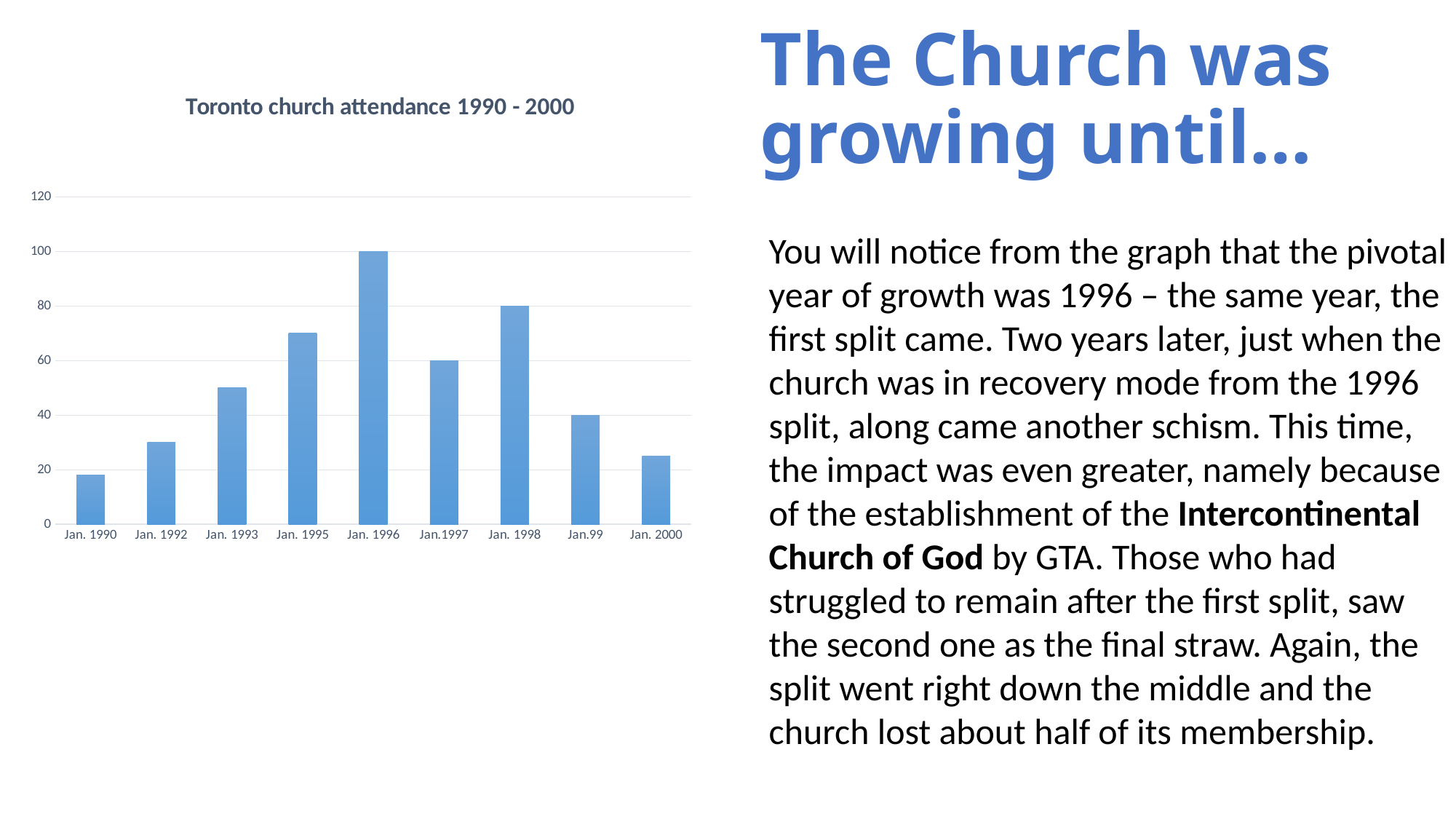
What is the attendance value for Jan. 1996? 100 How many bars (time points) are shown in the chart? 9 What is the attendance value for Jan.99? 40 What is the difference in attendance between Jan. 1996 and Jan. 1998? 20 Which time point has the highest attendance? Jan. 1996 Is the attendance for Jan. 1990 greater or less than 20? less What kind of chart is shown on the slide? Bar chart How does attendance change from Jan. 1996 to Jan. 2000? It falls Which time point has the lowest attendance? Jan. 1990 What is the title of the chart? Toronto church attendance 1990 - 2000 What is the attendance value for Jan. 1998? 80 Which is larger, the attendance for Jan. 1995 or for Jan.1997? Jan. 1995